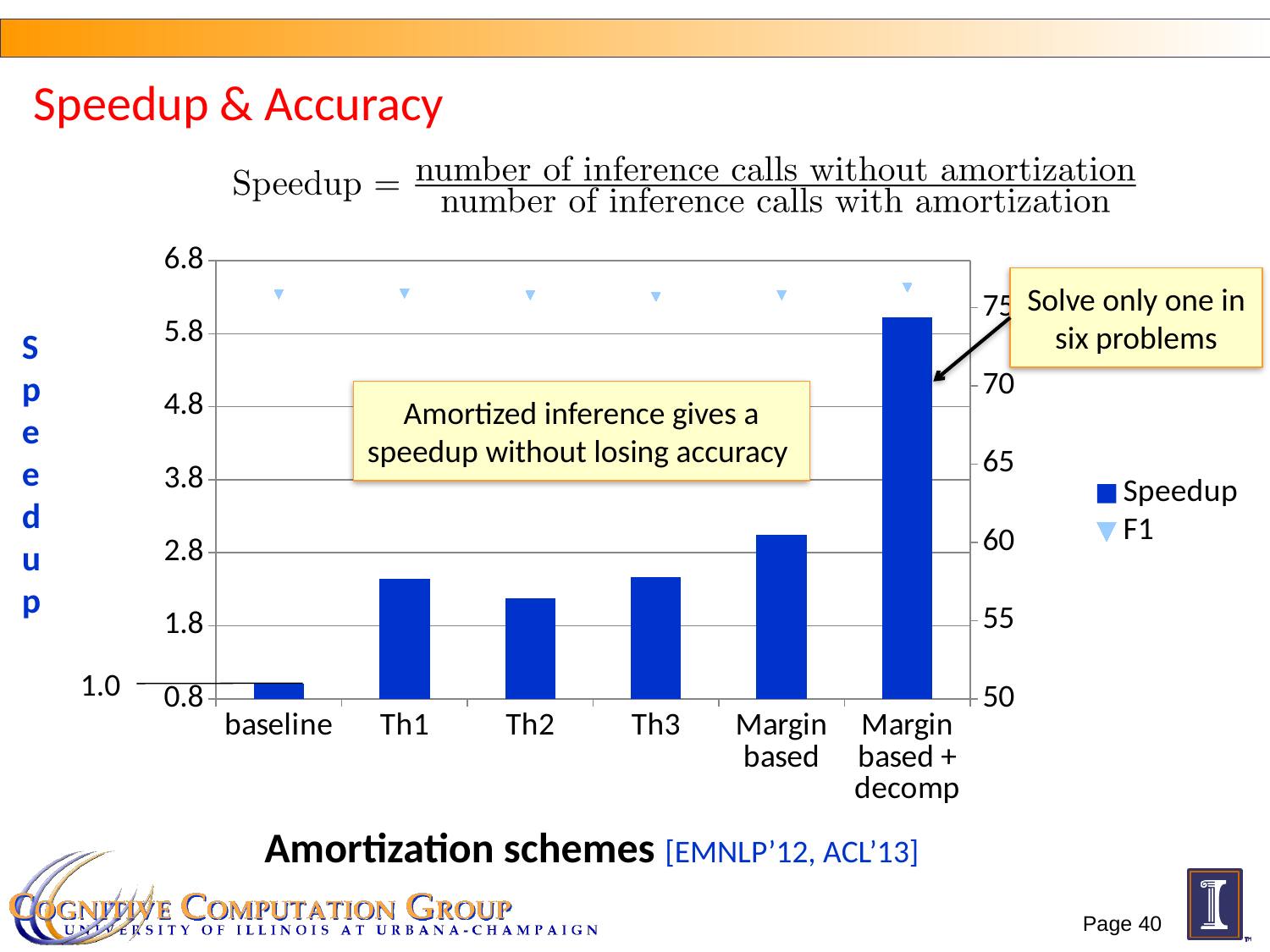
What is the Speedup value for baseline? 1.0 Which has the larger Speedup, Th1 or Th2? Th1 Is the Speedup for Th1 greater or less than 2.8? less Which has the larger Speedup, Margin based or Th3? Margin based What kind of chart is shown on the slide? bar chart How many amortization schemes (categories) are shown on the x axis? 6 Is the Speedup for Th2 greater or less than 1.8? greater What are the two series named in the legend? Speedup and F1 How many series does the legend list? 2 Which amortization scheme has the lowest Speedup? baseline Which amortization scheme has the highest Speedup? Margin based + decomp Is the Speedup for Margin based + decomp greater or less than 5.8? greater